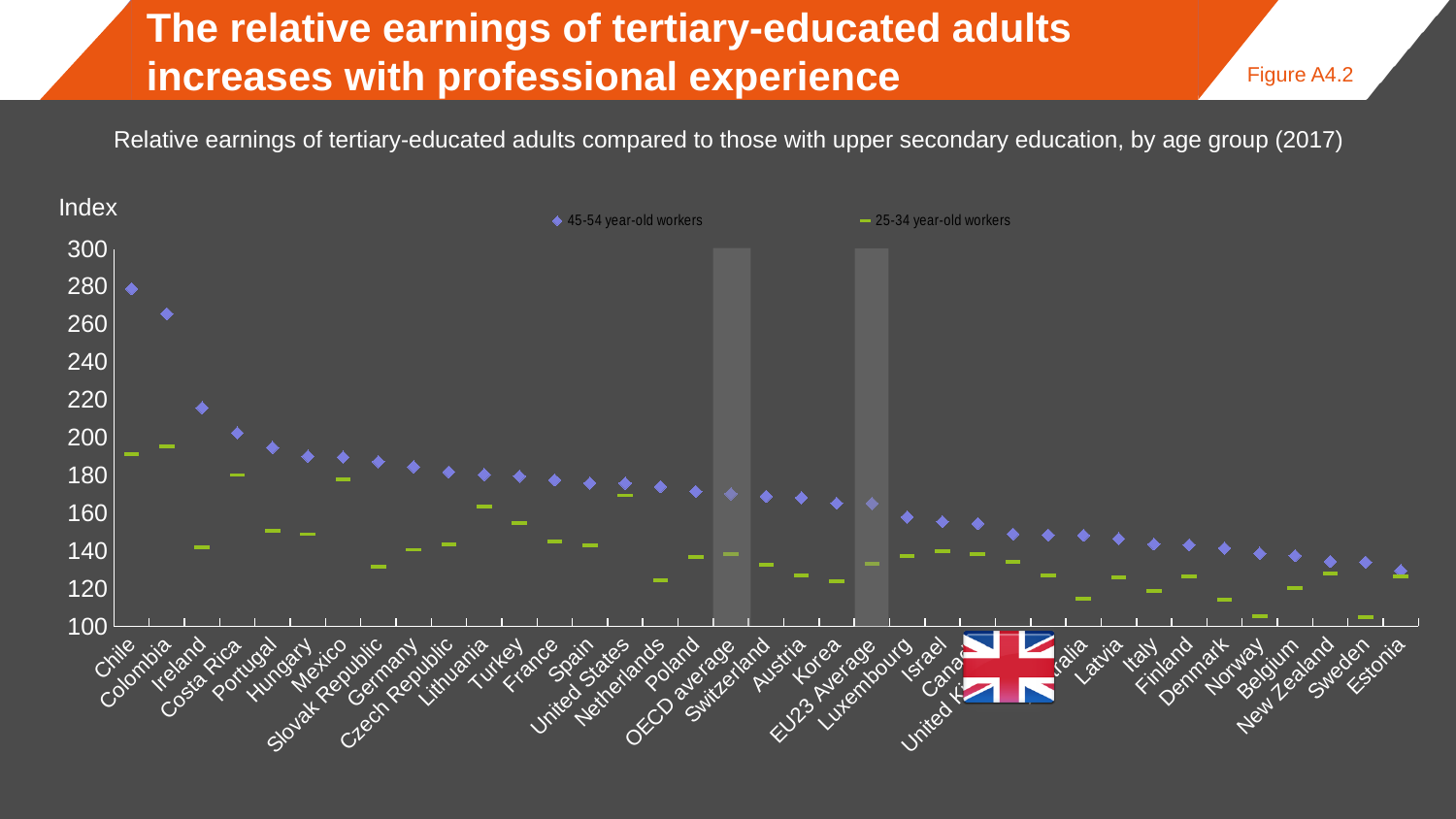
What are the two series named in the legend? 45-54 year-old workers and 25-34 year-old workers Is the value for 45-54 year-old workers in Chile greater or less than 260? greater Do the values for 45-54 year-old workers generally rise or fall from left to right across the countries? fall Which country has the highest value for 45-54 year-old workers? Chile Which is larger for 45-54 year-old workers: Chile or Colombia? Chile Is the value for 45-54 year-old workers in Ireland greater or less than 200? greater What kind of chart is shown on the slide? scatter chart What is the label on the vertical axis? Index Is the value for 25-34 year-old workers in the Netherlands greater or less than 140? less How many series does the legend list? 2